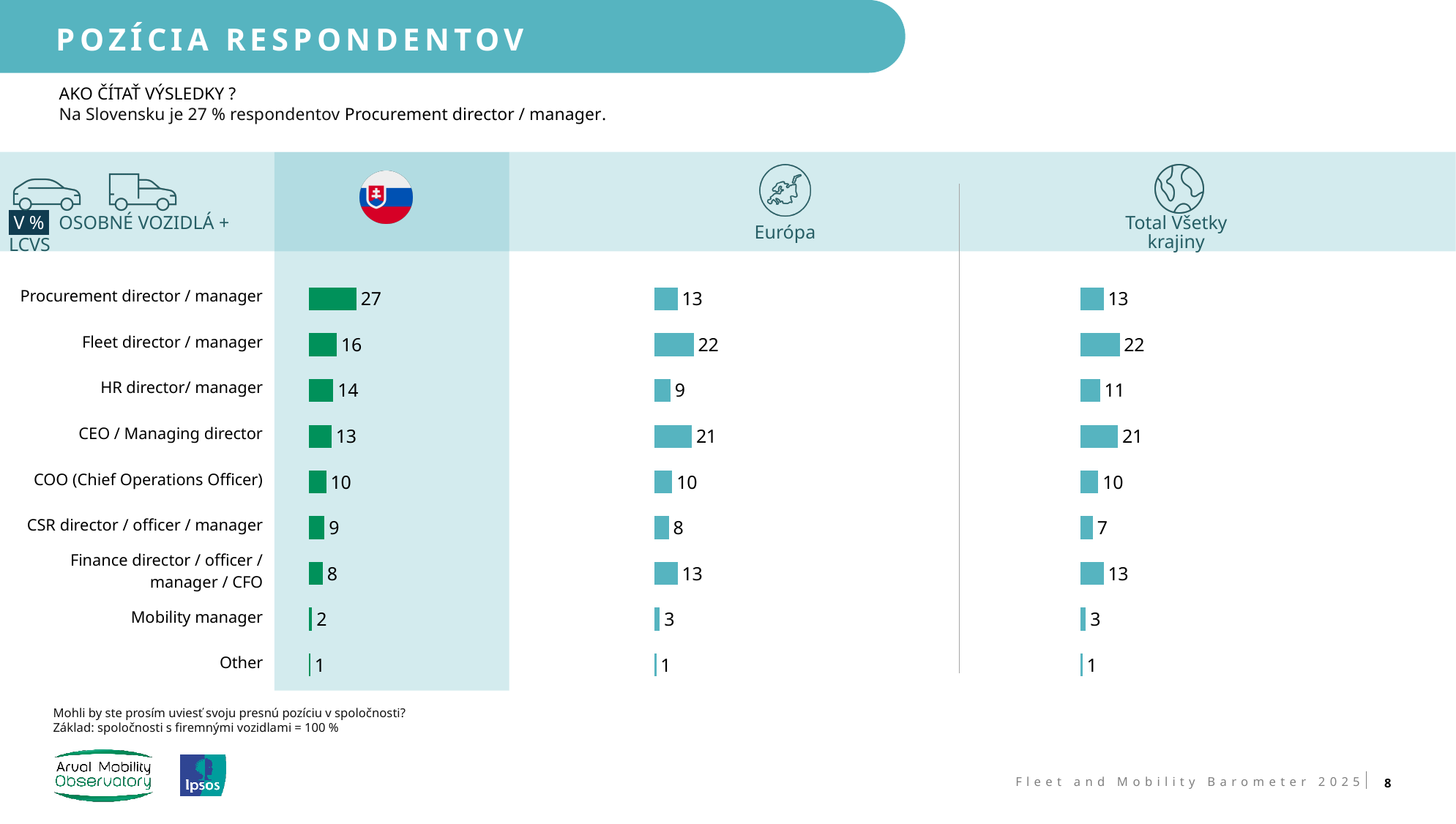
How many categories are shown in the left chart (Slovakia flag column)? 9 In the Európa chart, which category has the lowest value? Other In the Európa chart, what is the value for Fleet director / manager? 22 In the Európa chart, which is larger: CEO / Managing director or Procurement director / manager? CEO / Managing director In the Total Všetky krajiny chart, what is the difference between CEO / Managing director and COO (Chief Operations Officer)? 11 In the left chart (Slovakia flag column), what is the value for Procurement director / manager? 27 In the Total Všetky krajiny chart, what is the value for HR director/ manager? 11 In the Európa chart, which category has the highest value? Fleet director / manager In the left chart (Slovakia flag column), which category has the highest value? Procurement director / manager In the left chart (Slovakia flag column), what is the difference between Procurement director / manager and Fleet director / manager? 11 What kind of chart is the Európa chart? Bar chart In the Total Všetky krajiny chart, what is the value for CSR director / officer / manager? 7